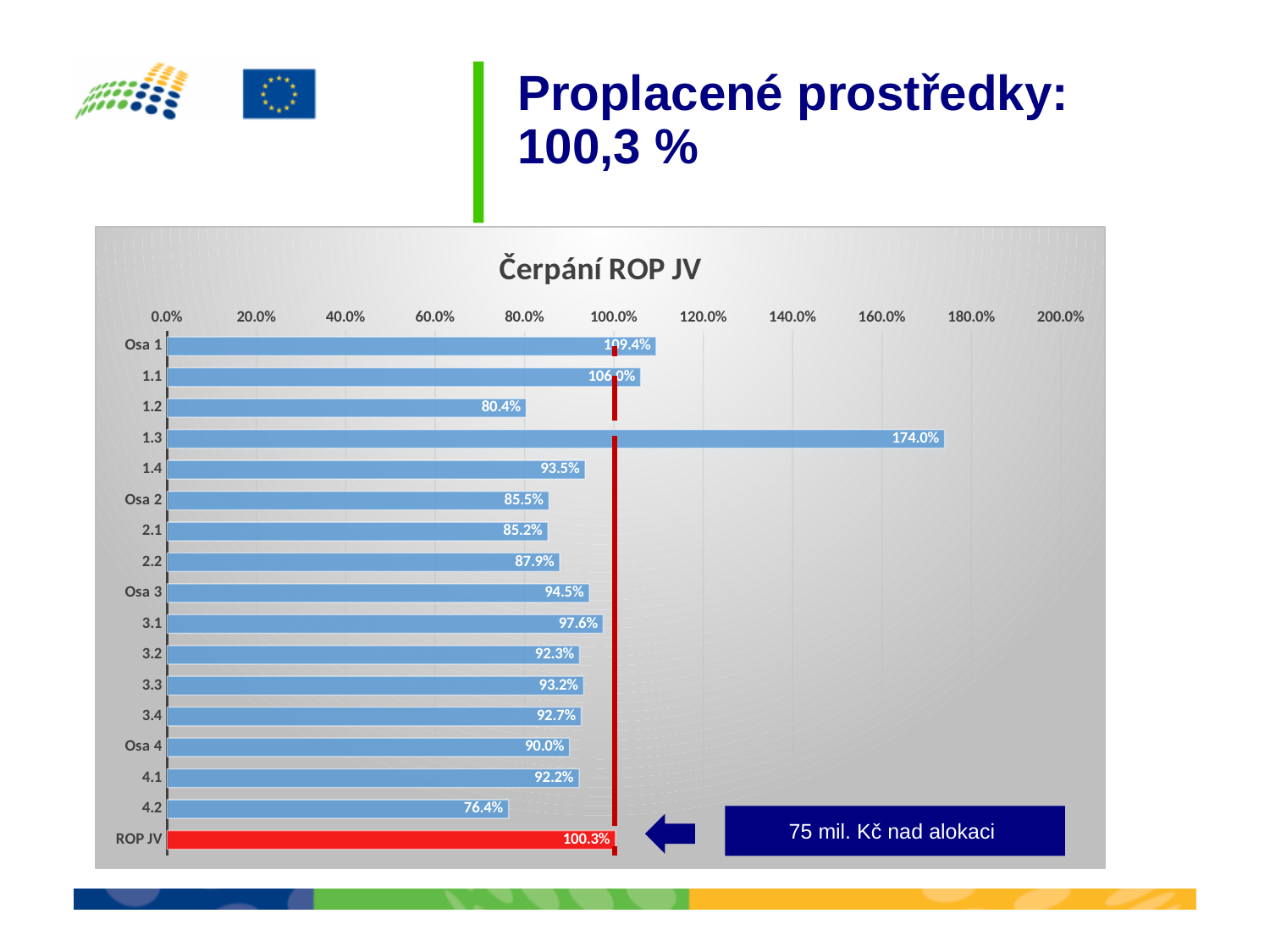
How many categories are shown on the chart? 17 What type of chart is shown on the slide? bar chart Which category has the highest value? 1.3 Is the value for 1.1 greater or less than 100.0%? greater What is the value for 4.2? 76.4% What is the value for ROP JV? 100.3% Which is larger, the value for 3.1 or the value for 3.2? 3.1 What is the value for 1.3? 174.0% What is the value for Osa 3? 94.5% What is the title of the chart? Čerpání ROP JV What is the difference between the values for 1.3 and 1.2? 93.6% Which category has the lowest value? 4.2